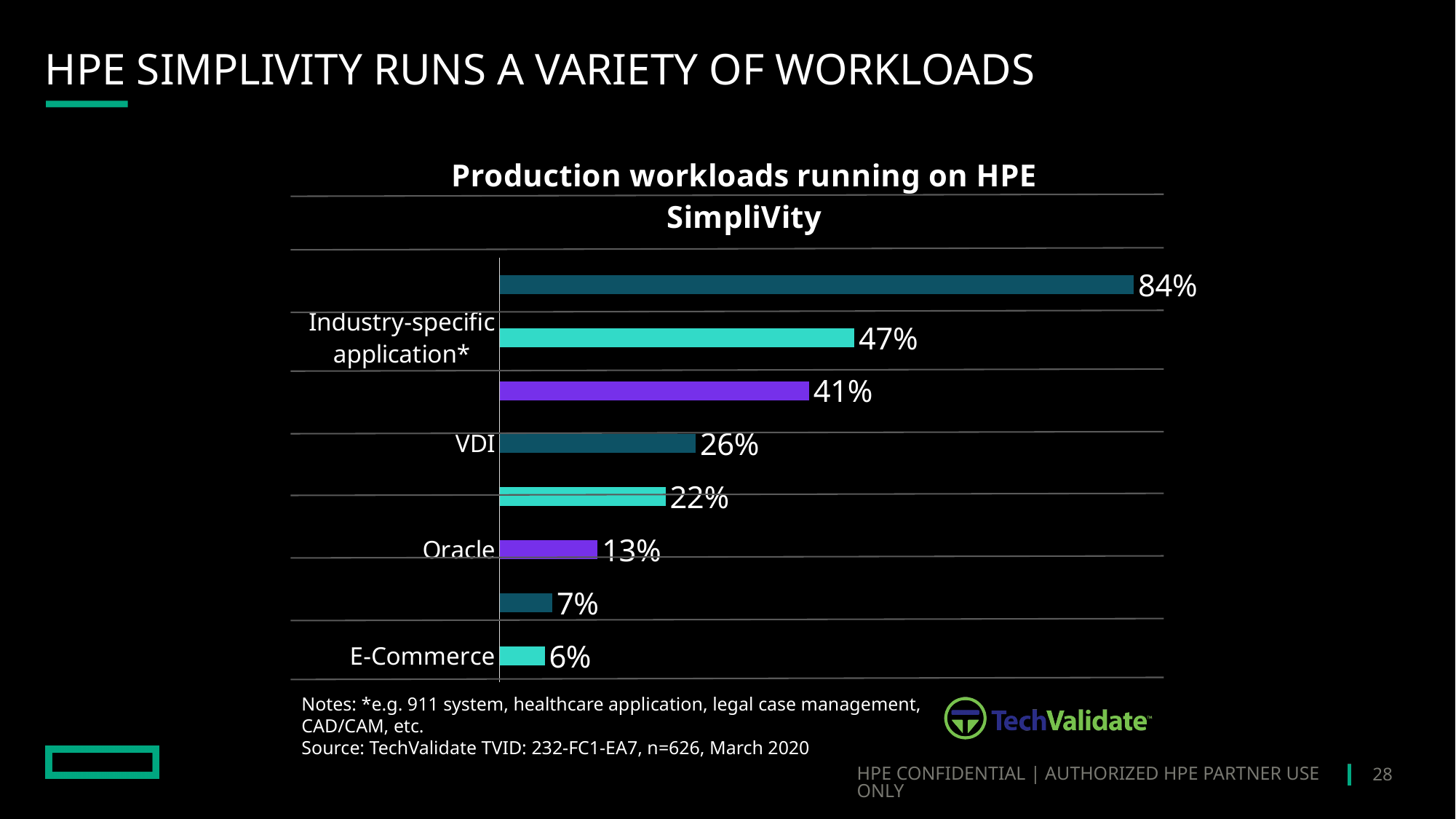
What percentage is shown for VDI? 26% What type of chart is shown on the slide? bar chart What percentage is shown for Industry-specific application*? 47% How many bars are plotted on the chart? 8 What is the difference between the values for VDI and Oracle? 13% Which of the labelled categories has the lowest value? E-Commerce What is the highest value shown on the chart? 84% What percentage is shown for E-Commerce? 6% What is the title of the chart? Production workloads running on HPE SimpliVity What percentage is shown for Oracle? 13% What is the difference between the values for Industry-specific application* and E-Commerce? 41% Which is larger, the value for Industry-specific application* or the value for VDI? Industry-specific application*